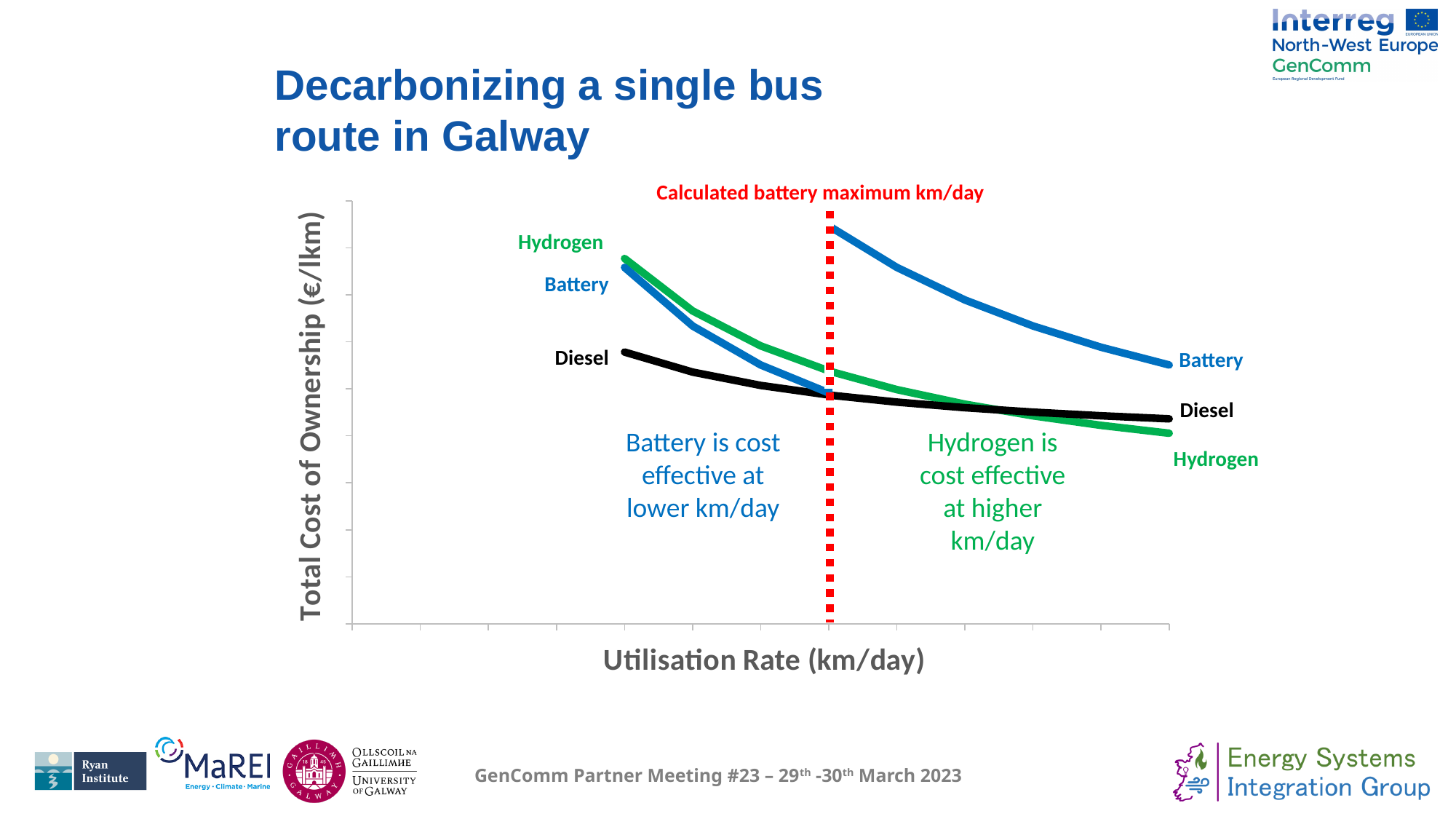
Which series has the lowest total cost of ownership at the left-hand end of the chart? Diesel How many series (lines) are plotted on the chart? 3 Which series has the highest total cost of ownership at the right-hand end of the chart? Battery Do the Battery line values rise or fall as the utilisation rate increases? Fall What does the red dashed vertical line on the chart represent? Calculated battery maximum km/day What kind of chart is shown on the slide? Line chart At the left-hand end of the chart, which is higher: the Hydrogen line or the Diesel line? Hydrogen Do the Diesel line values rise or fall along the x axis? Fall What is the label of the y axis? Total Cost of Ownership (€/lkm) Which series has the lowest total cost of ownership at the right-hand end of the chart? Hydrogen What is the label of the x axis? Utilisation Rate (km/day) At the right-hand end of the chart, which is higher: the Battery line or the Diesel line? Battery